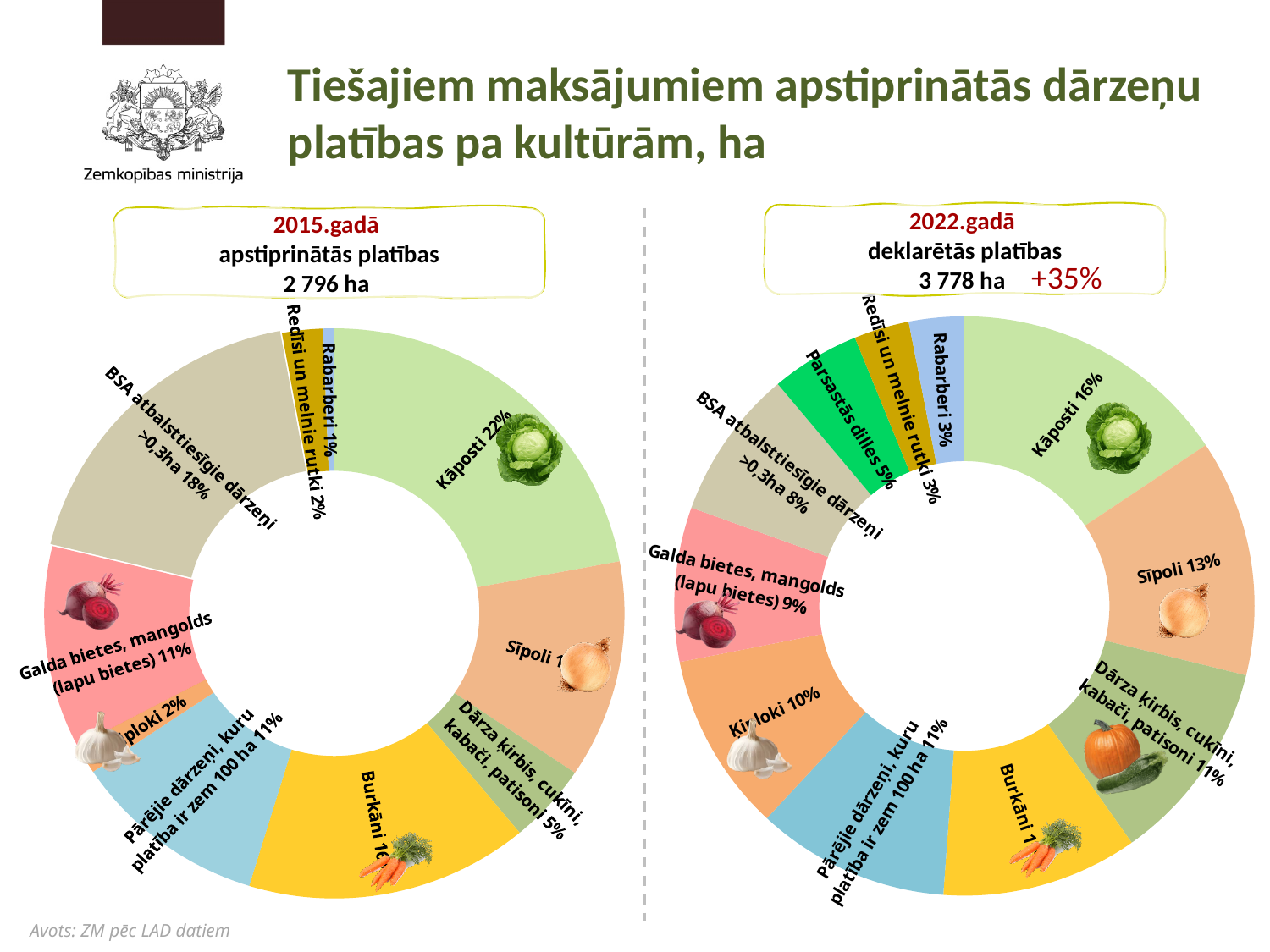
In the 2015.gadā chart, what share does BSA atbalsttiesīgie dārzeņi >0,3ha have? 18% In the 2015.gadā chart, which category has the smallest share? Rabarberi What is the difference between the share of Kāposti in the 2015.gadā chart and in the 2022.gadā chart? 6 percentage points How many categories are shown in the 2022.gadā chart? 11 In the 2022.gadā chart, what share does Parastās dilles have? 5% In the 2015.gadā chart, what share does Kāposti have? 22% In the 2022.gadā chart, what share does Ķiploki have? 10% What type of chart is used on the slide for the 2015 and 2022 data? Pie chart (doughnut) In the 2022.gadā chart, which is larger: the share of Galda bietes, mangolds (lapu bietes) or the share of BSA atbalsttiesīgie dārzeņi >0,3ha? Galda bietes, mangolds (lapu bietes) In the 2022.gadā chart, what share does Sīpoli have? 13% In the 2015.gadā chart, which category has the largest share? Kāposti What total area in hectares is stated above the 2022.gadā chart? 3 778 ha